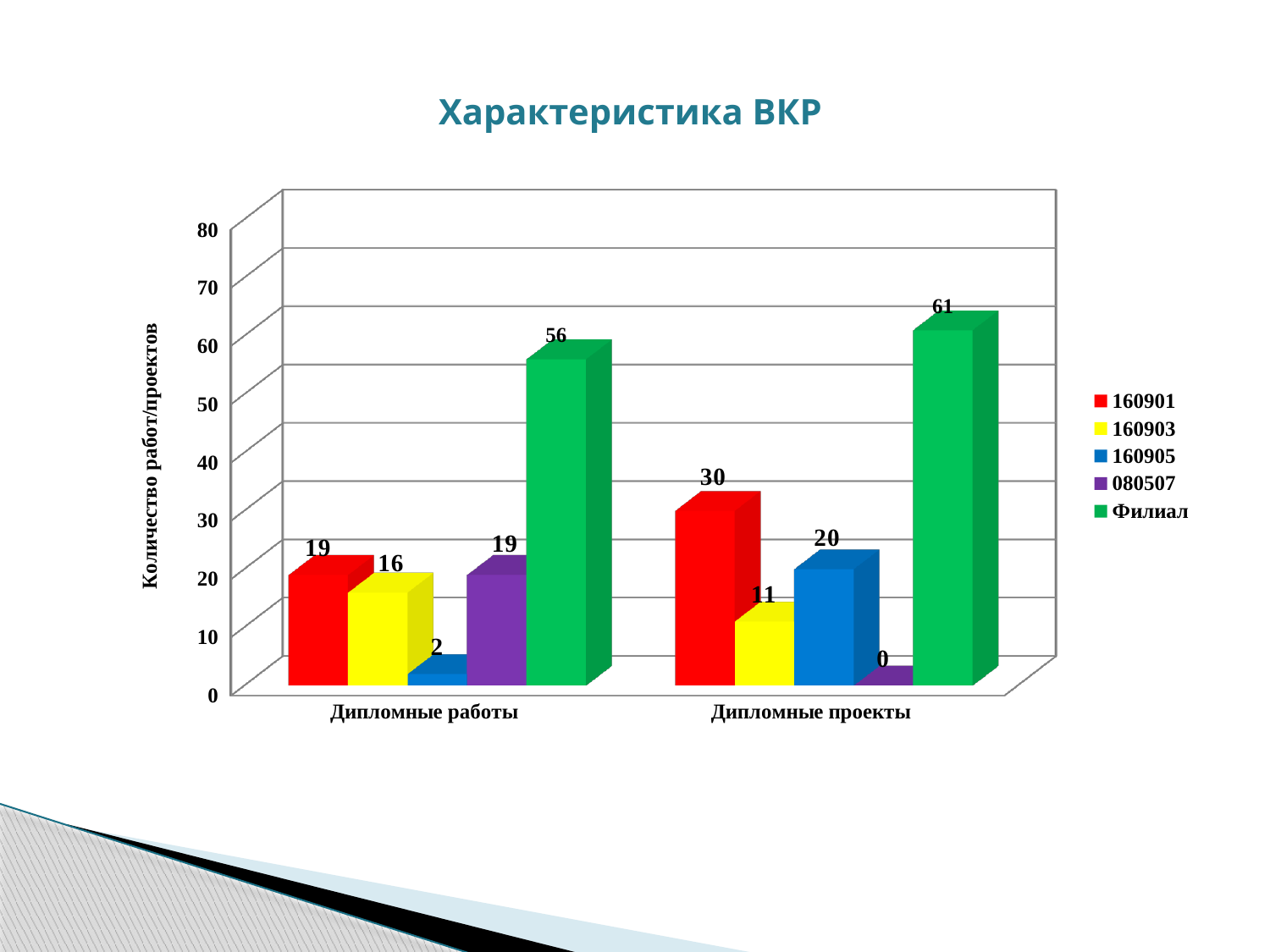
How many series does the legend list? 5 How many categories are shown on the x axis? 2 What is the value for 080507 in the Дипломные проекты category? 0 What kind of chart is shown on the slide? Bar chart What is the value for 160901 in the Дипломные проекты category? 30 What is the value for Филиал in the Дипломные работы category? 56 What is the value for 160905 in the Дипломные работы category? 2 What is the title of the y axis? Количество работ/проектов Which is larger: the 160903 value for Дипломные работы or for Дипломные проекты? Дипломные работы Which series has the lowest value in the Дипломные работы category? 160905 Which series has the highest value in the Дипломные проекты category? Филиал What is the difference between the Филиал values for Дипломные проекты and Дипломные работы? 5